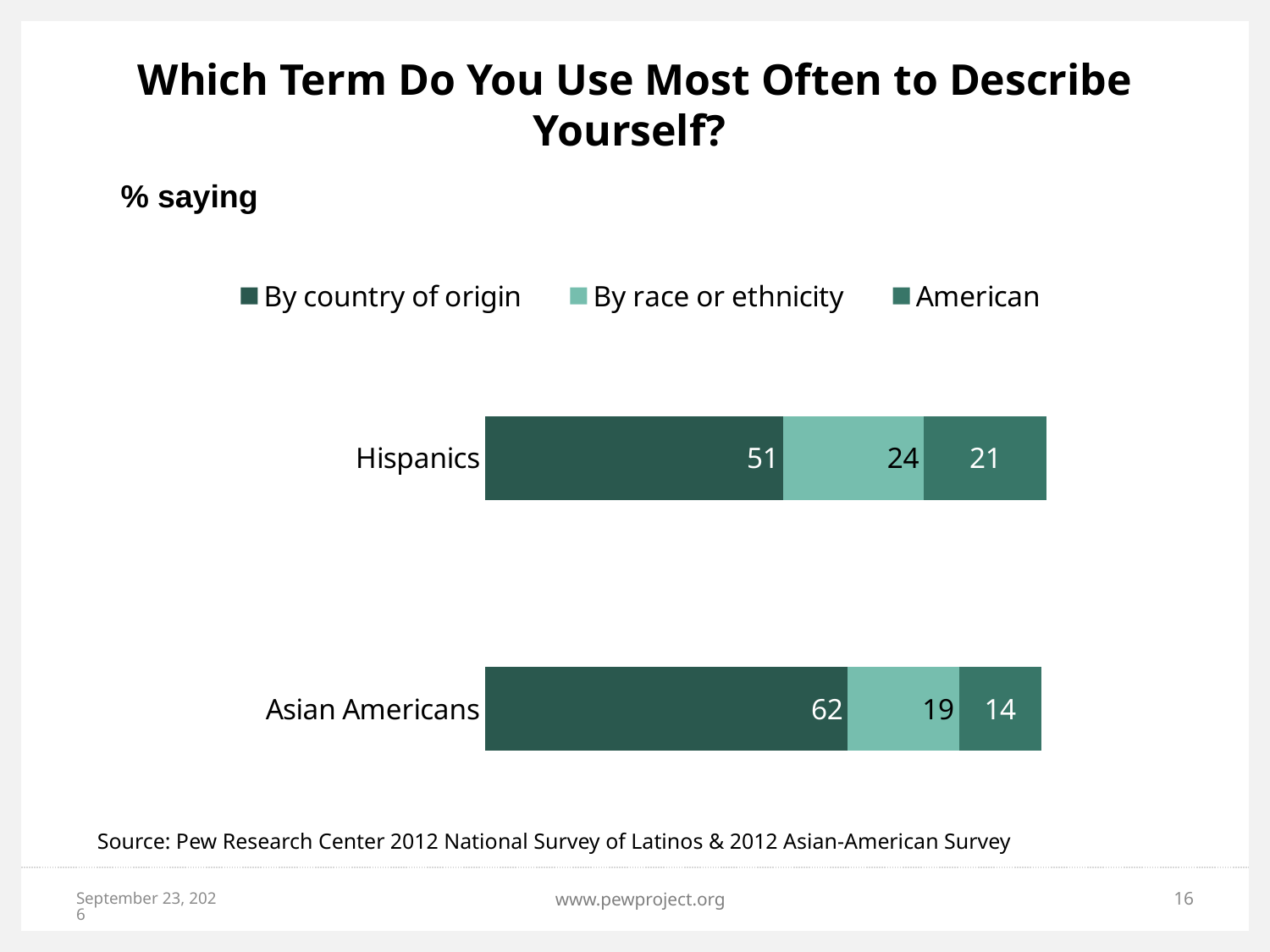
What is the difference between the 'By race or ethnicity' values for Hispanics and Asian Americans? 5 What kind of chart is shown on the slide? Stacked bar chart What percentage of Asian Americans say they describe themselves by race or ethnicity? 19 What is the total of the stacked bar for Hispanics? 96 Which group has the higher value for 'By country of origin'? Asian Americans What is the difference between the 'By country of origin' values for Asian Americans and Hispanics? 11 What percentage of Asian Americans say they describe themselves as American? 14 How many groups are shown on the chart? 2 What is the total of the stacked bar for Asian Americans? 95 What percentage of Hispanics say they describe themselves by country of origin? 51 How many series does the legend list? 3 Which group has the higher value for 'American'? Hispanics